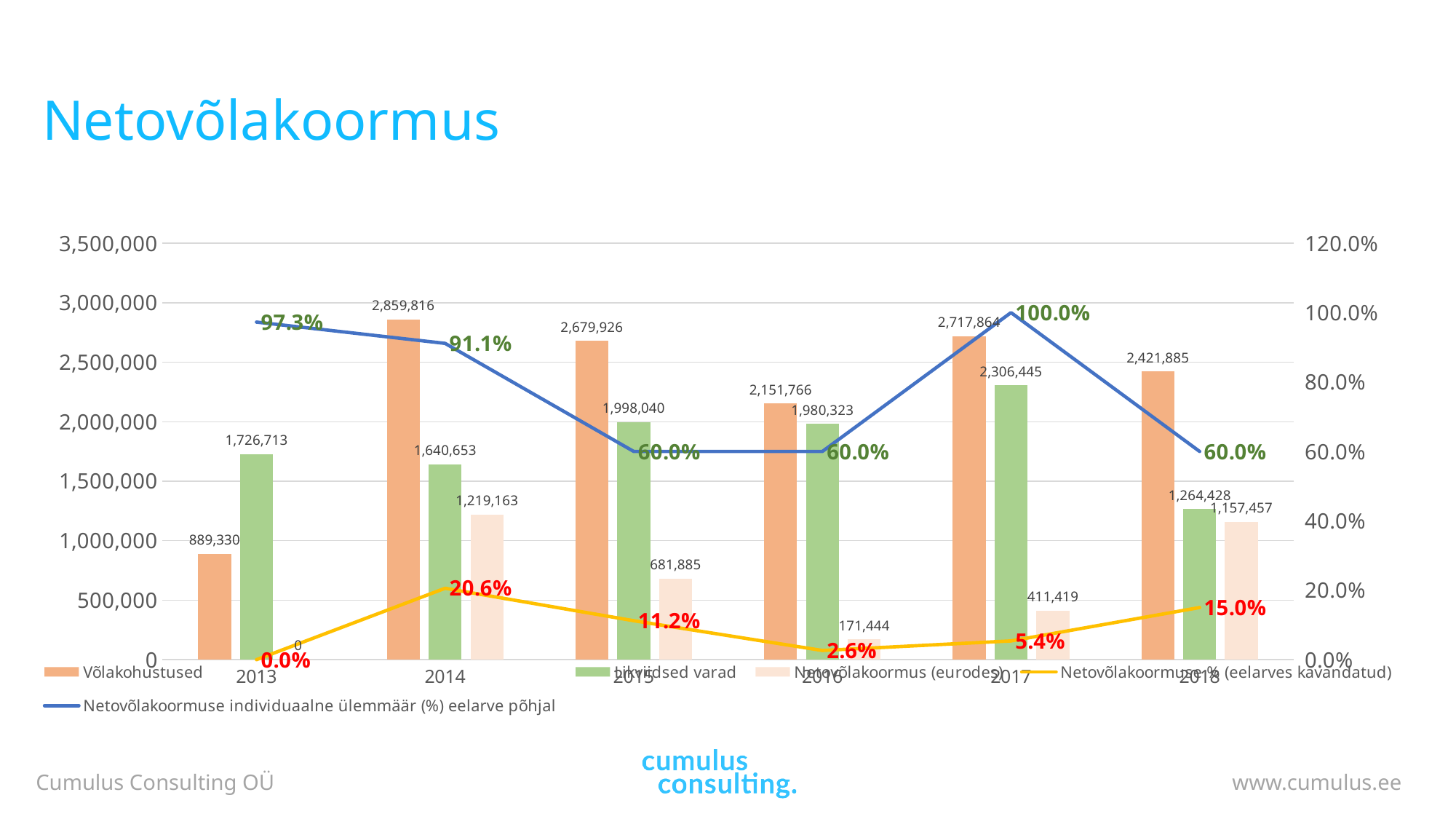
What is the Netovõlakoormus (eurodes) value for 2015? 681,885 What is the Netovõlakoormuse % (eelarves kavandatud) value for 2018? 15.0% In which year is Võlakohustused the highest? 2014 In 2015, which is larger: Võlakohustused or Likviidsed varad? Võlakohustused How many years are shown on the x axis? 6 What is the value of Likviidsed varad in 2017? 2,306,445 How many series does the legend list? 5 In which year is Likviidsed varad the lowest? 2018 What is the value of Võlakohustused in 2014? 2,859,816 What is the Netovõlakoormuse individuaalne ülemmäär (%) value for 2017? 100.0% In which year is Netovõlakoormuse % (eelarves kavandatud) the highest? 2014 What is the difference between Võlakohustused in 2014 and in 2013? 1,970,486